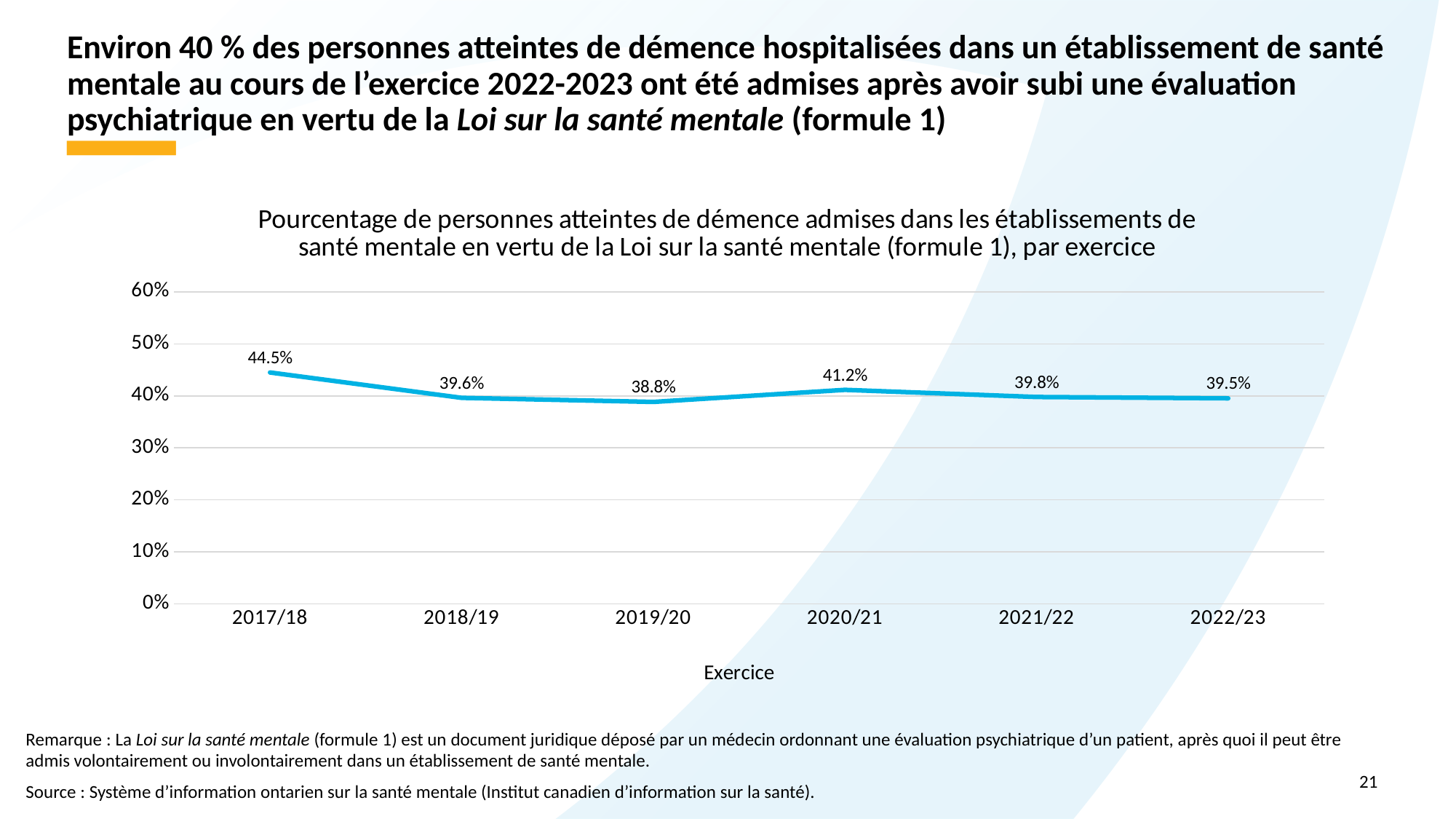
What is the difference between the values for 2017/18 and 2022/23? 5.0% Which is larger, the value for 2018/19 or the value for 2020/21? 2020/21 What is the value for 2020/21? 41.2% What is the value for 2017/18? 44.5% Which fiscal year has the lowest value? 2019/20 Which fiscal year has the highest value? 2017/18 Does the value rise or fall from 2017/18 to 2018/19? Fall What is the value for 2019/20? 38.8% What is the value for 2022/23? 39.5% What is the label of the x axis? Exercice How many fiscal years are plotted on the chart? 6 What kind of chart is shown on the slide? Line chart